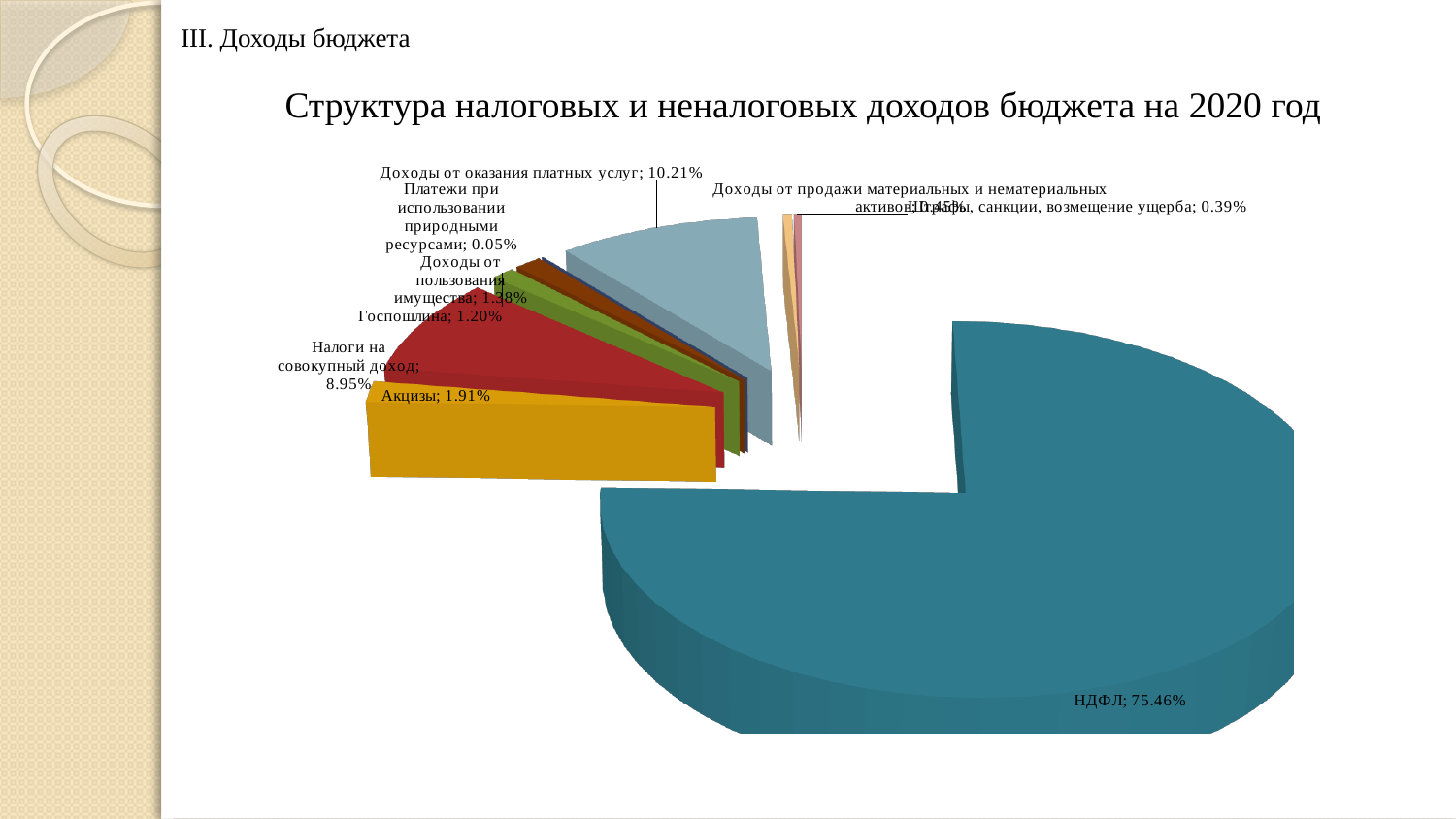
What is the title of the chart? Структура налоговых и неналоговых доходов бюджета на 2020 год What is the value for Налоги на совокупный доход? 8.95% What is the value for Акцизы? 1.91% What is the value for Штрафы, санкции, возмещение ущерба? 0.39% What is the value for Доходы от оказания платных услуг? 10.21% What is the value for Госпошлина? 1.20% What is the difference between the shares of НДФЛ and Доходы от оказания платных услуг? 65.25% What kind of chart is shown on the slide? pie chart What share of the pie does НДФЛ account for? 75.46% Which category has the smallest share of the pie? Платежи при использовании природными ресурсами Which is larger, the share of Налоги на совокупный доход or the share of Акцизы? Налоги на совокупный доход Which category has the largest share of the pie? НДФЛ